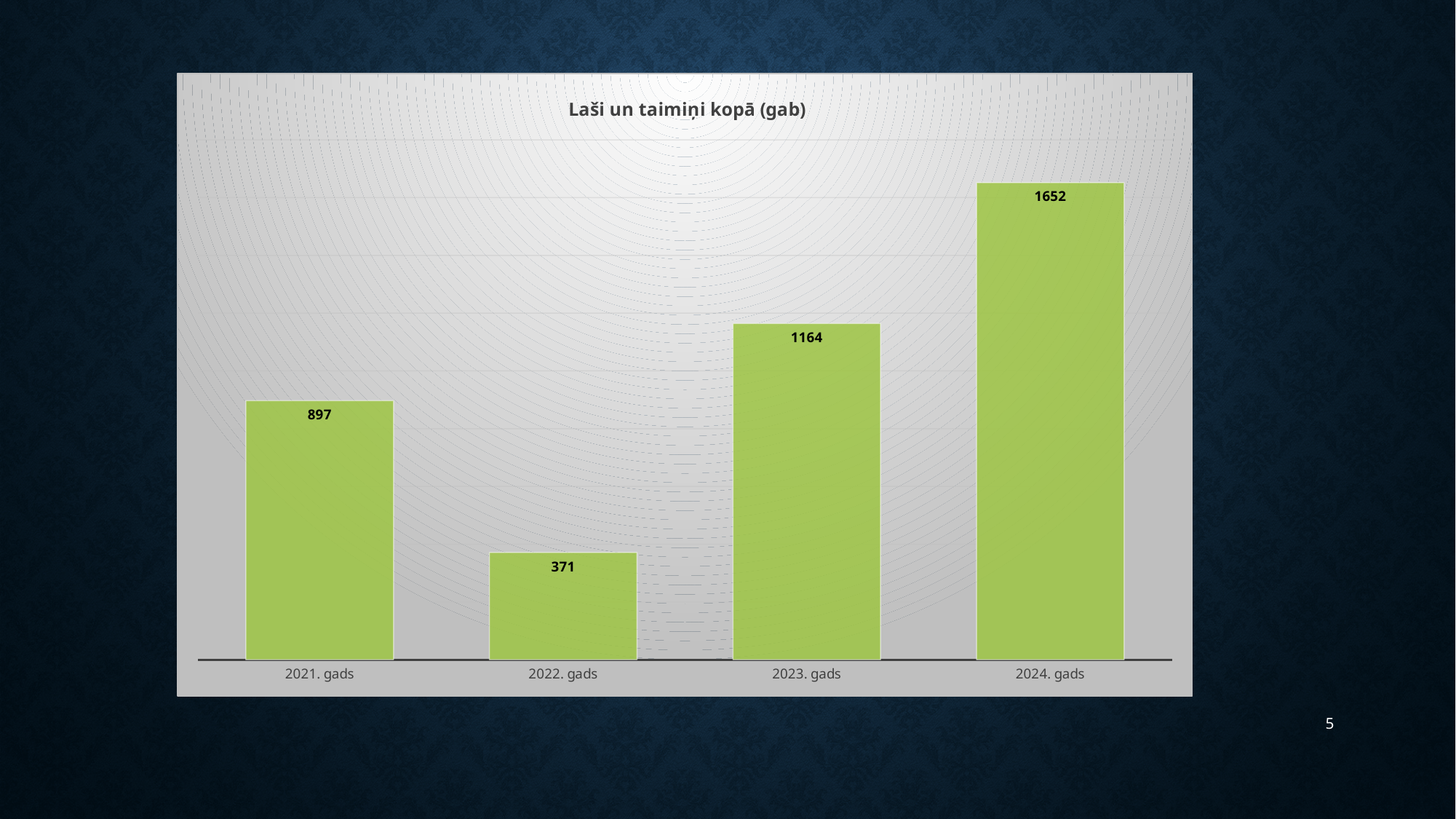
What is the value for 2022. gads? 371 What is the value for 2023. gads? 1164 What is the title of the chart? Laši un taimiņi kopā (gab) What kind of chart is this? bar chart What is the value for 2024. gads? 1652 How many years are shown on the chart? 4 Which year has the highest value? 2024. gads What is the difference between the values for 2021. gads and 2022. gads? 526 What is the value for 2021. gads? 897 Which year has the lowest value? 2022. gads What is the difference between the values for 2024. gads and 2023. gads? 488 Which is larger, the value for 2021. gads or the value for 2023. gads? 2023. gads